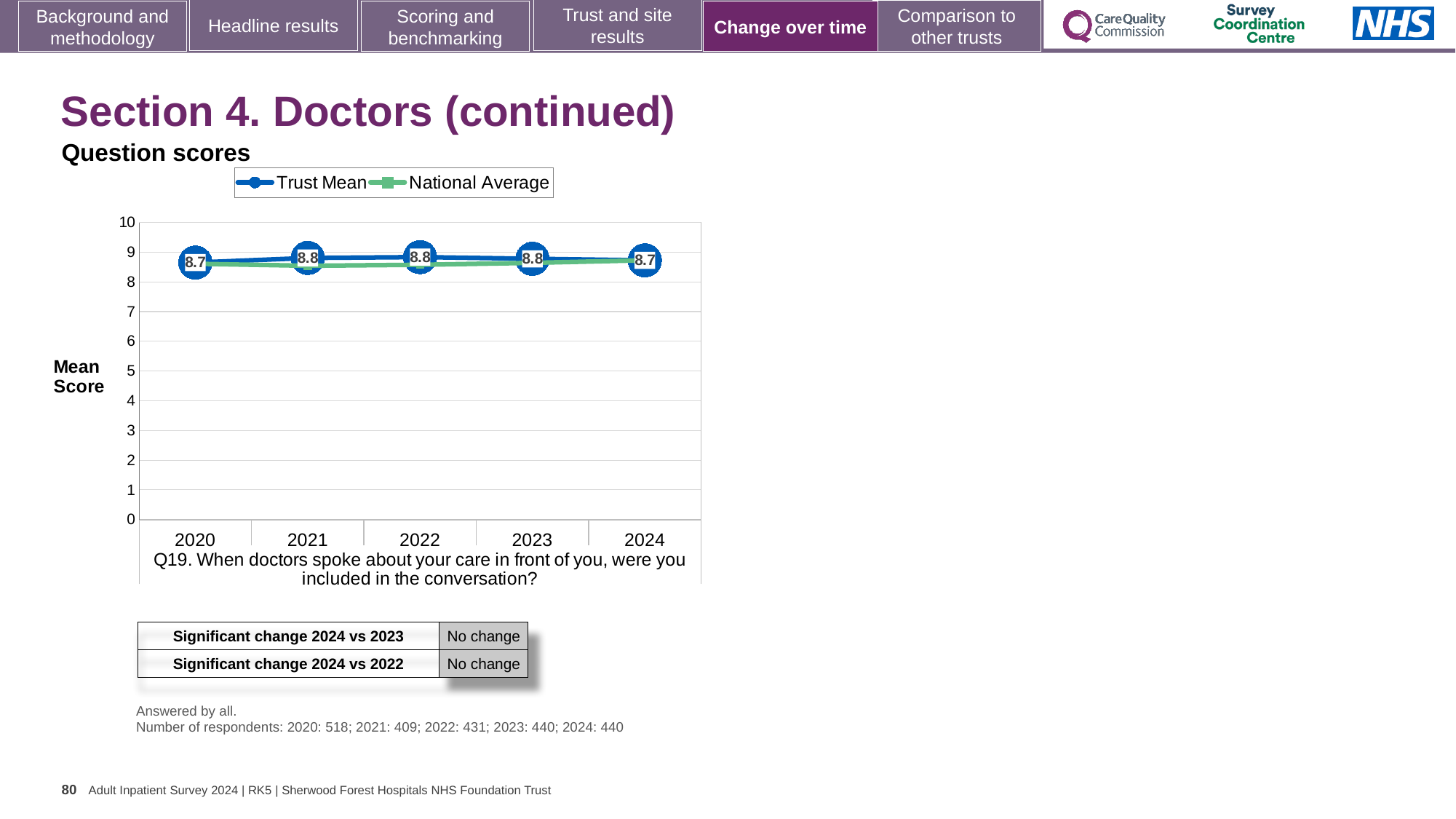
What is the difference between the Trust Mean score in 2021 and in 2024? 0.1 What is the label on the y axis of the chart? Mean Score How many years are plotted on the x axis of the chart? 5 How many series does the chart legend list? 2 What is the Trust Mean score for 2024? 8.7 What kind of chart is shown on the slide? Line chart Which series is shown in blue in the chart legend? Trust Mean Is the Trust Mean score for 2023 greater or less than 8? greater Is the National Average for 2020 greater or less than 8? greater What is the Trust Mean score for 2022? 8.8 What is the Trust Mean score for 2021? 8.8 What is the Trust Mean score for 2020? 8.7